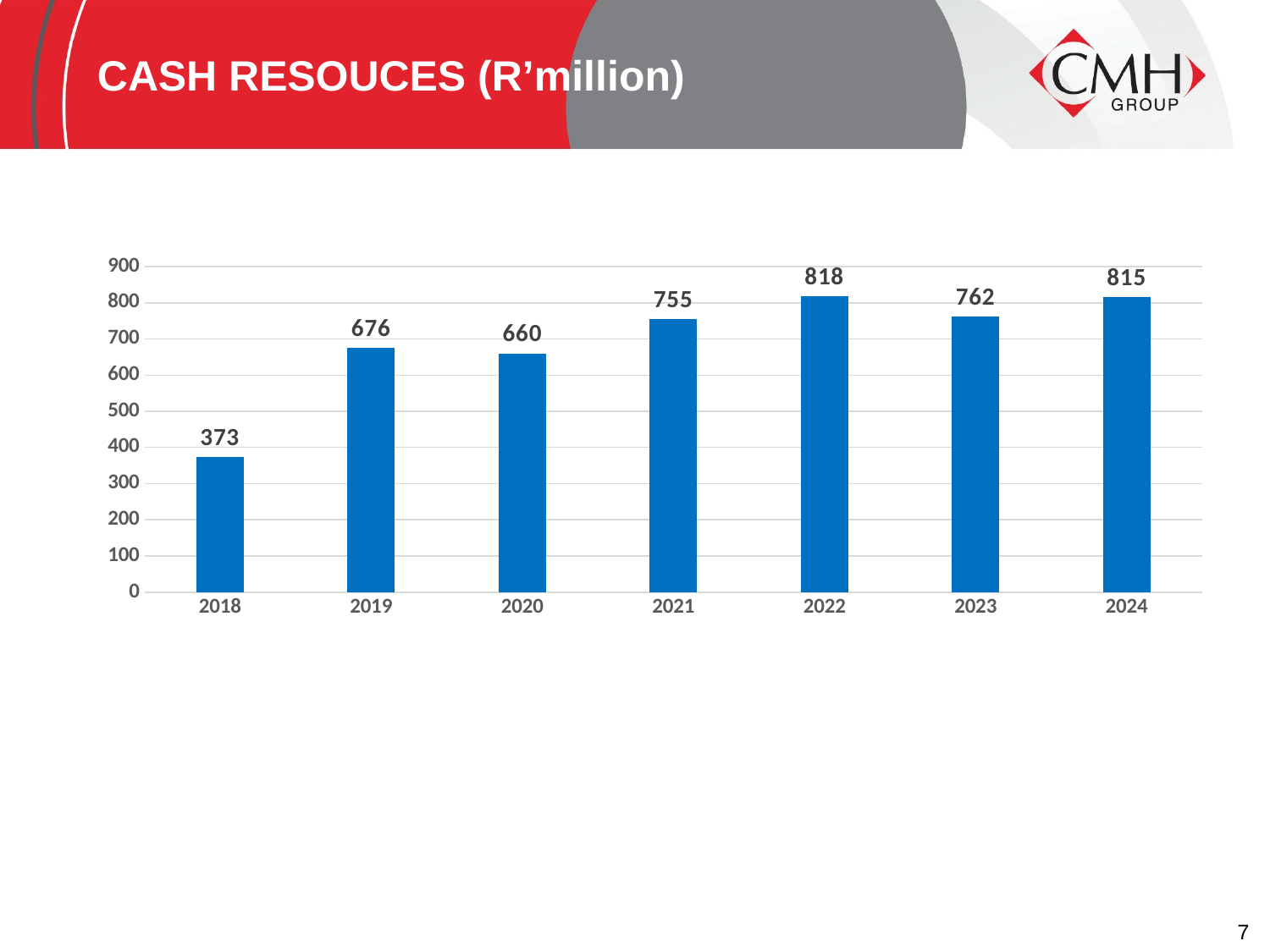
Which year has higher cash resources, 2019 or 2020? 2019 What is the cash resources value for 2024? 815 What kind of chart is shown on the slide? Bar chart Is the value for 2023 greater or less than 700? greater Which year has the lowest cash resources? 2018 What is the difference between the cash resources in 2019 and 2018? 303 What is the cash resources value for 2018? 373 What is the difference between the cash resources in 2022 and 2023? 56 What is the title of the slide? CASH RESOUCES (R'million) What is the cash resources value for 2021? 755 How many years are shown on the chart? 7 Which year has the highest cash resources? 2022